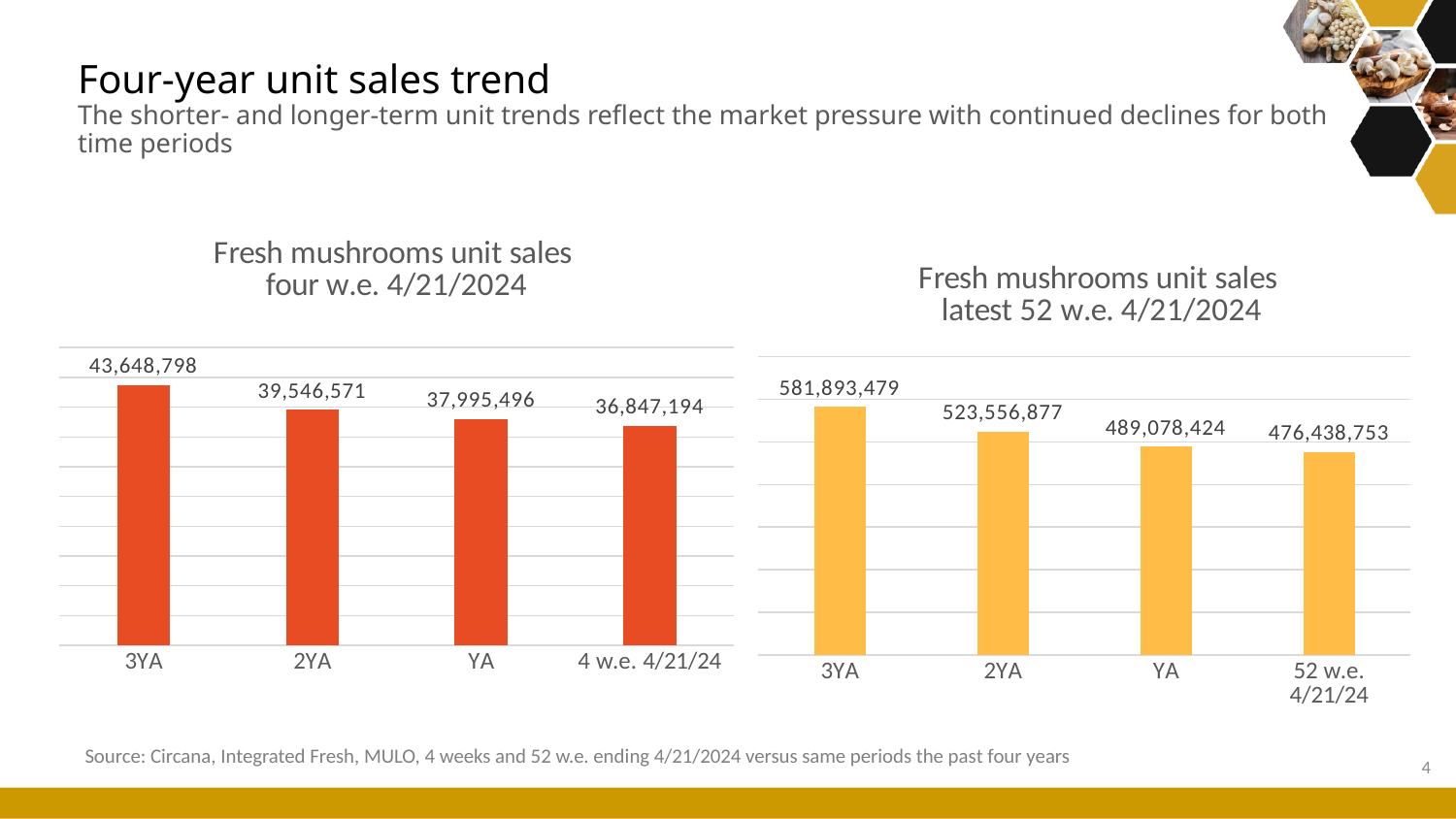
In the 'Fresh mushrooms unit sales four w.e. 4/21/2024' chart, which category has the highest value? 3YA In the 'Fresh mushrooms unit sales four w.e. 4/21/2024' chart, what is the value for 4 w.e. 4/21/24? 36,847,194 How many categories are shown in the 'Fresh mushrooms unit sales four w.e. 4/21/2024' chart? 4 What kind of chart is the 'Fresh mushrooms unit sales latest 52 w.e. 4/21/2024' chart? Bar chart In the 'Fresh mushrooms unit sales latest 52 w.e. 4/21/2024' chart, which is larger, the value for 3YA or the value for YA? 3YA In the 'Fresh mushrooms unit sales latest 52 w.e. 4/21/2024' chart, what is the value for 52 w.e. 4/21/24? 476,438,753 In the 'Fresh mushrooms unit sales latest 52 w.e. 4/21/2024' chart, what is the value for 2YA? 523,556,877 In the 'Fresh mushrooms unit sales latest 52 w.e. 4/21/2024' chart, what is the difference between the 2YA value and the YA value? 34,478,453 In the 'Fresh mushrooms unit sales four w.e. 4/21/2024' chart, do the values rise or fall from 3YA to 4 w.e. 4/21/24? Fall In the 'Fresh mushrooms unit sales four w.e. 4/21/2024' chart, what is the difference between the 3YA value and the 4 w.e. 4/21/24 value? 6,801,604 In the 'Fresh mushrooms unit sales four w.e. 4/21/2024' chart, what is the value for 3YA? 43,648,798 In the 'Fresh mushrooms unit sales latest 52 w.e. 4/21/2024' chart, which category has the lowest value? 52 w.e. 4/21/24